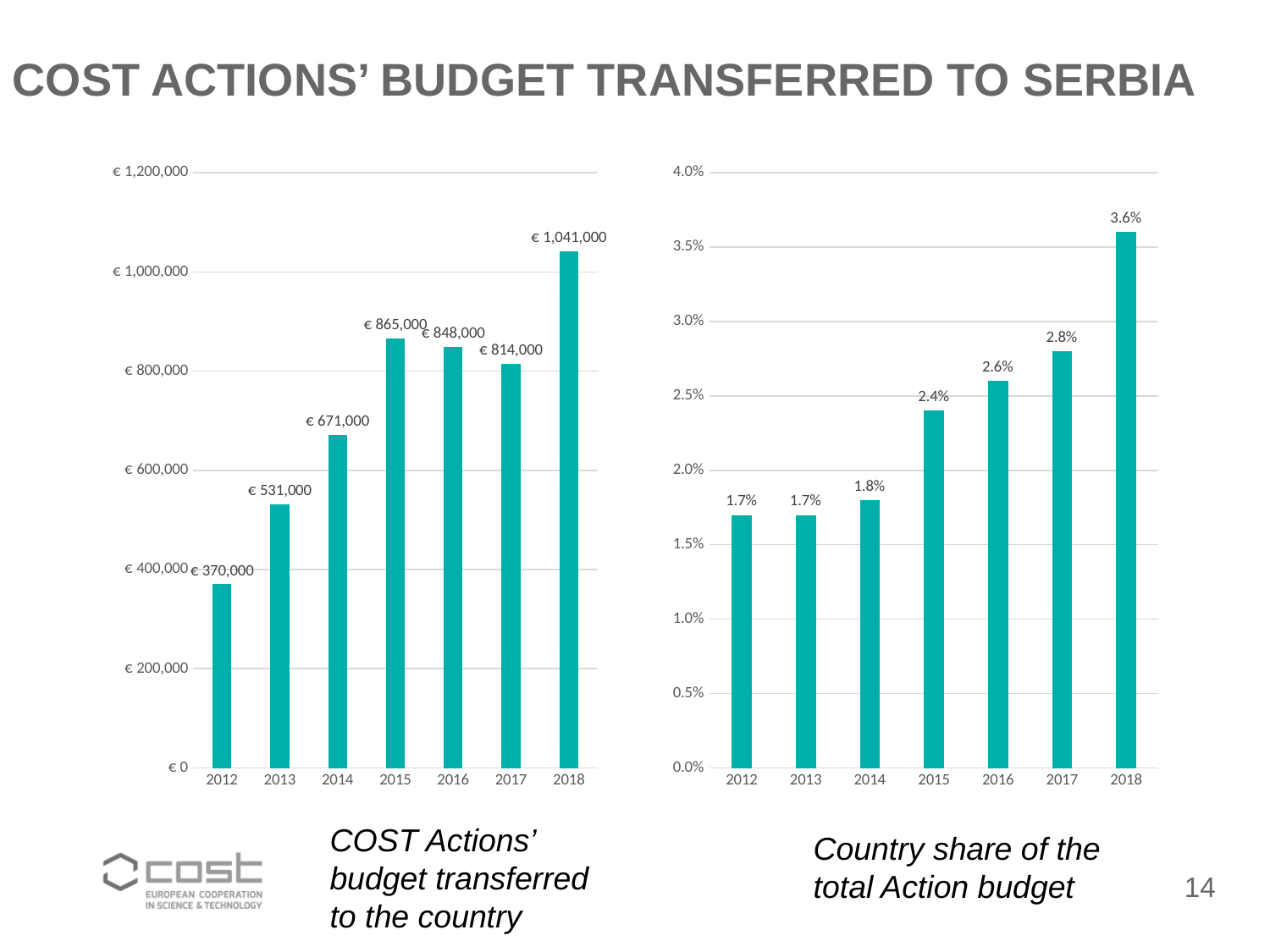
In the left chart (COST Actions' budget transferred to the country), what was the budget transferred in 2012? € 370,000 In the right chart (Country share of the total Action budget), which year had the highest share? 2018 In the right chart (Country share of the total Action budget), what is the difference between the 2018 and 2017 shares? 0.8% In the left chart (COST Actions' budget transferred to the country), which is larger, the value for 2016 or the value for 2017? 2016 In the left chart (COST Actions' budget transferred to the country), which year had the highest budget transferred? 2018 What kind of chart is the left chart (COST Actions' budget transferred to the country)? Bar chart In the left chart (COST Actions' budget transferred to the country), which year had the lowest budget transferred? 2012 In the right chart (Country share of the total Action budget), what was the country share in 2014? 1.8% In the left chart (COST Actions' budget transferred to the country), what is the difference between the 2015 and 2014 values? € 194,000 In the right chart (Country share of the total Action budget), what was the country share in 2017? 2.8% How many years are shown on the x axis of the right chart (Country share of the total Action budget)? 7 In the left chart (COST Actions' budget transferred to the country), what was the budget transferred in 2018? € 1,041,000